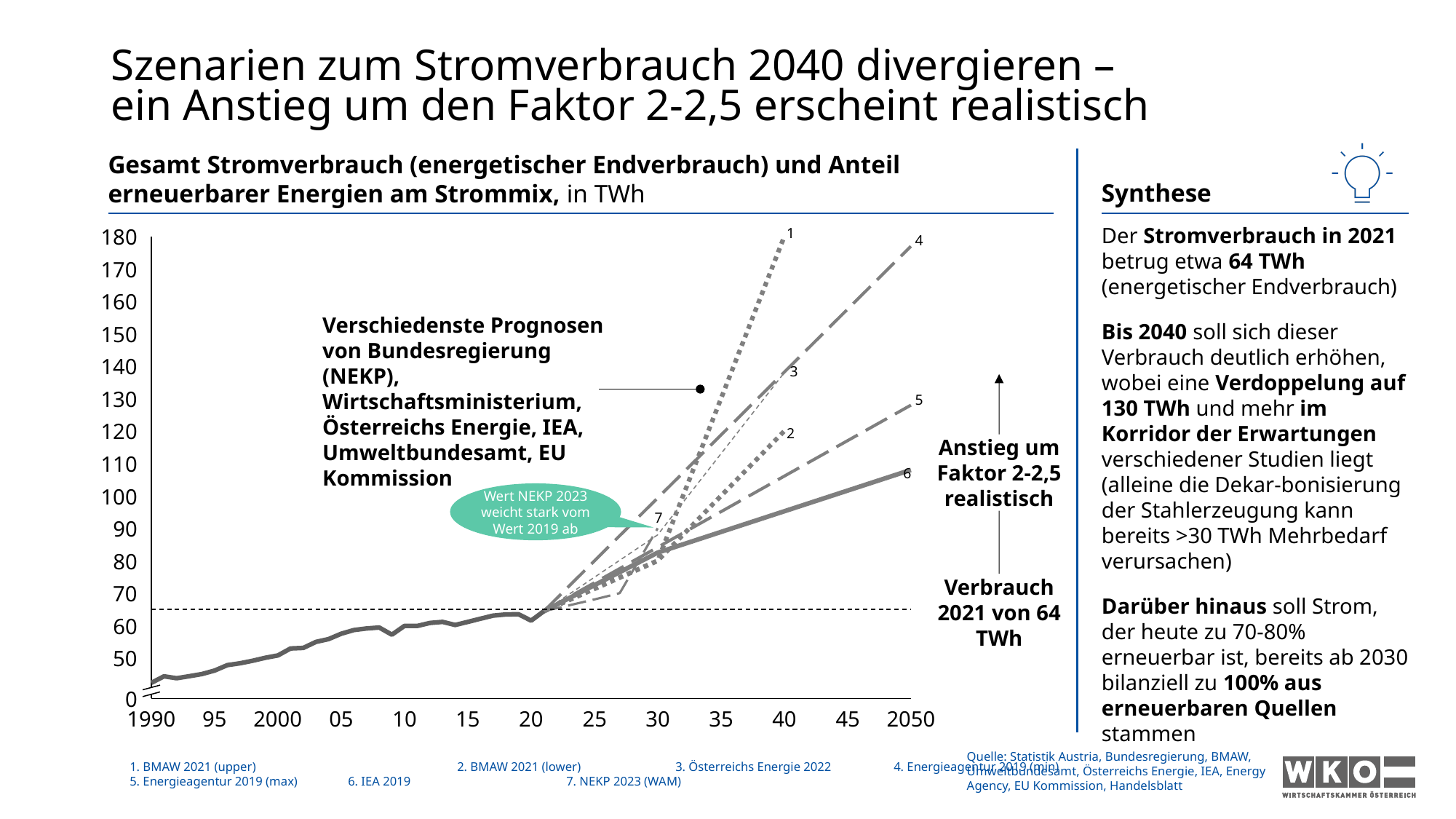
What kind of chart is shown on the slide? line chart Is the value of scenario line 1 at 2040 greater or less than 170? greater How many numbered scenario lines are plotted in the chart? 7 Which numbered scenario line is the lowest at 2050? 6 According to the annotation on the chart, what was the electricity consumption in 2021? 64 TWh Is the value of scenario line 3 at 2040 greater or less than 120? greater Which numbered scenario line reaches the highest value at 2040? 1 Which source does the legend give for scenario line 7? NEKP 2023 (WAM) At 2040, which is higher: scenario line 1 or scenario line 2? scenario line 1 Does the historical consumption line rise or fall between 1990 and 2020? rises Is the value of scenario line 6 at 2050 greater or less than 100? greater In what unit are the values on the chart given? TWh